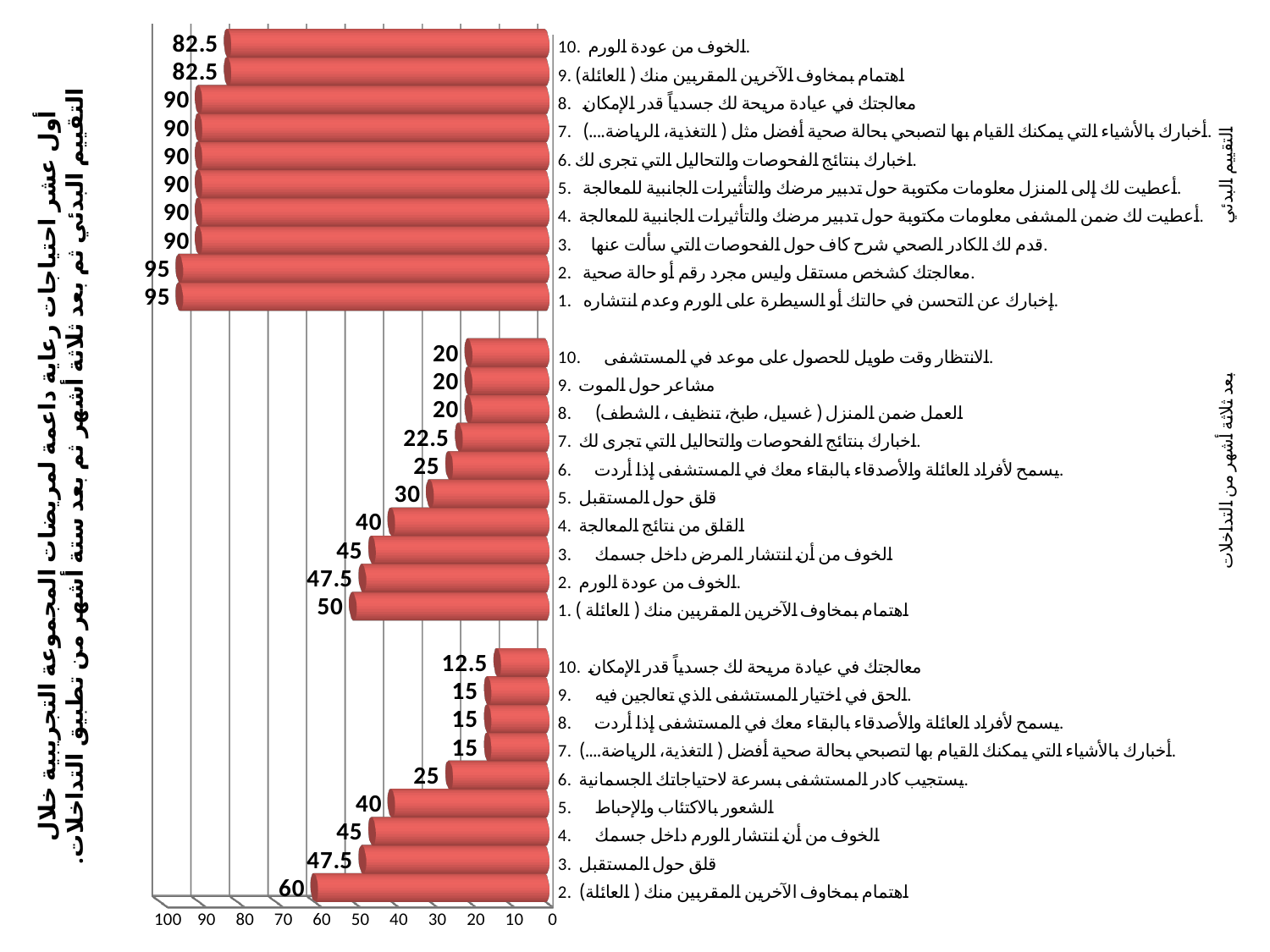
In the التقييم البدئي group, what is the value for item 1, "إخبارك عن التحسن في حالتك أو السيطرة على الورم وعدم انتشاره"? 95 In the بعد ثلاثة أشهر من التداخلات group, what is the value for "الانتظار وقت طويل للحصول على موعد في المستشفى"? 20 What kind of chart is shown on the slide? bar chart In the bottom group, what is the value for "الشعور بالاكتئاب والإحباط"? 40 Which item in the bottom group has the highest value? اهتمام بمخاوف الآخرين المقربين منك (العائلة) Which item in the bottom group has the lowest value? معالجتك في عيادة مريحة لك جسدياً قدر الإمكان What is the difference between the value for "قلق حول المستقبل" in the bottom group and in the بعد ثلاثة أشهر من التداخلات group? 17.5 What is the maximum value shown on the horizontal axis? 100 Which item in the بعد ثلاثة أشهر من التداخلات group has the highest value? اهتمام بمخاوف الآخرين المقربين منك (العائلة) How many bars are plotted in the chart in total? 29 In the بعد ثلاثة أشهر من التداخلات group, what is the value for "مشاعر حول الموت"? 20 Is the value for "الخوف من عودة الورم" larger in the التقييم البدئي group or in the بعد ثلاثة أشهر من التداخلات group? التقييم البدئي